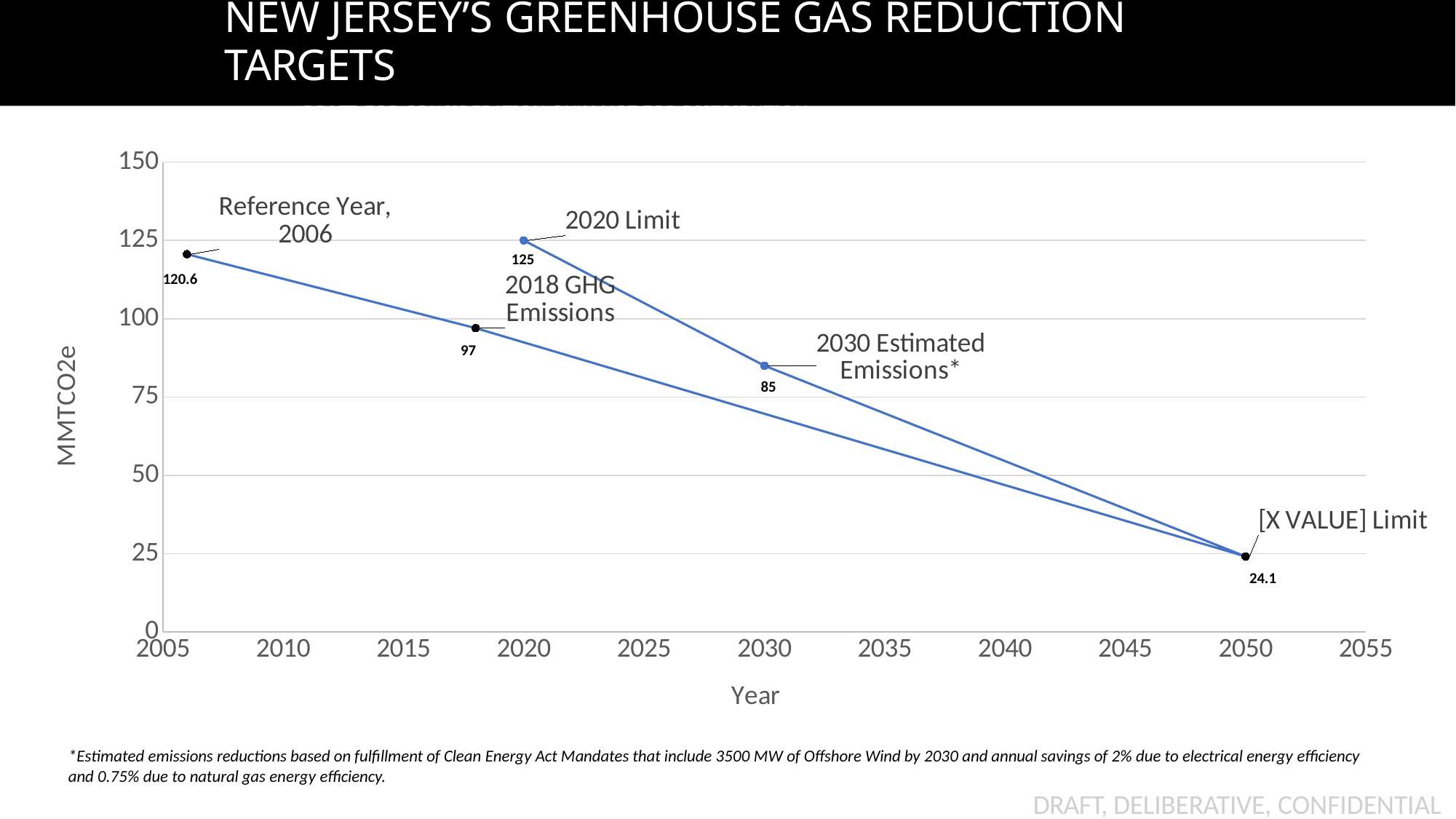
Which labelled point has the lowest value? [X VALUE] Limit (2050) What is the value for the Reference Year, 2006 point? 120.6 What is the value of the 2020 Limit point? 125 What is the difference between the Reference Year, 2006 value and the 2018 GHG Emissions value? 23.6 What is the difference between the 2020 Limit value and the 2030 Estimated Emissions value? 40 What is the label of the y axis? MMTCO2e What is the value for 2030 Estimated Emissions? 85 Which labelled point has the highest value? 2020 Limit Which is larger, the 2018 GHG Emissions value or the 2030 Estimated Emissions value? 2018 GHG Emissions What is the value for 2018 GHG Emissions? 97 What is the value of the point at 2050? 24.1 Do the plotted values rise or fall as the year increases? fall